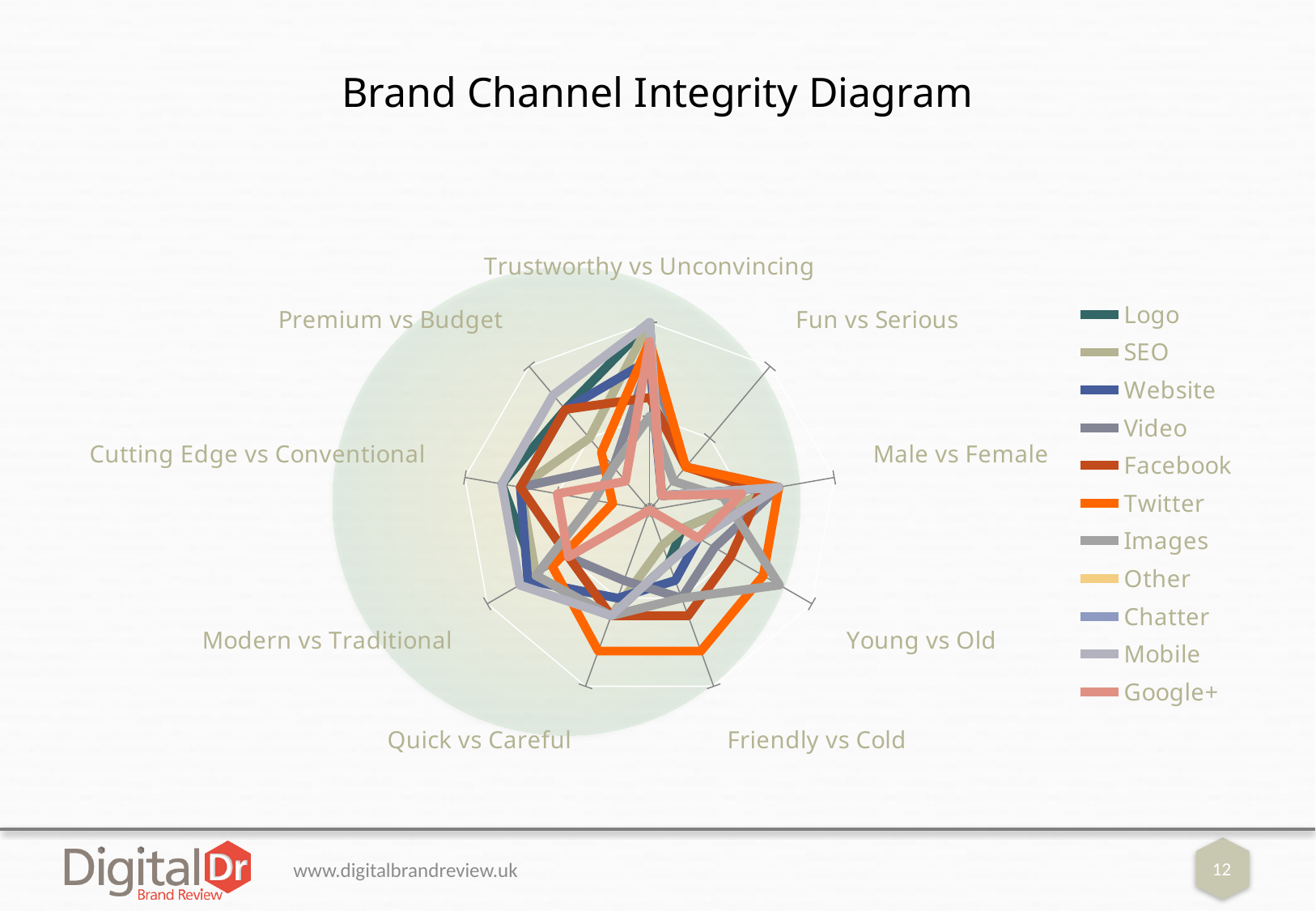
Which series extends furthest along the Quick vs Careful axis? Twitter What is the title of the chart? Brand Channel Integrity Diagram How many series does the legend list? 11 Which series extends furthest along the Young vs Old axis? Images How many axes (categories) does the radar chart have? 9 Which series is listed last in the legend? Google+ What kind of chart is shown on the slide? Radar chart